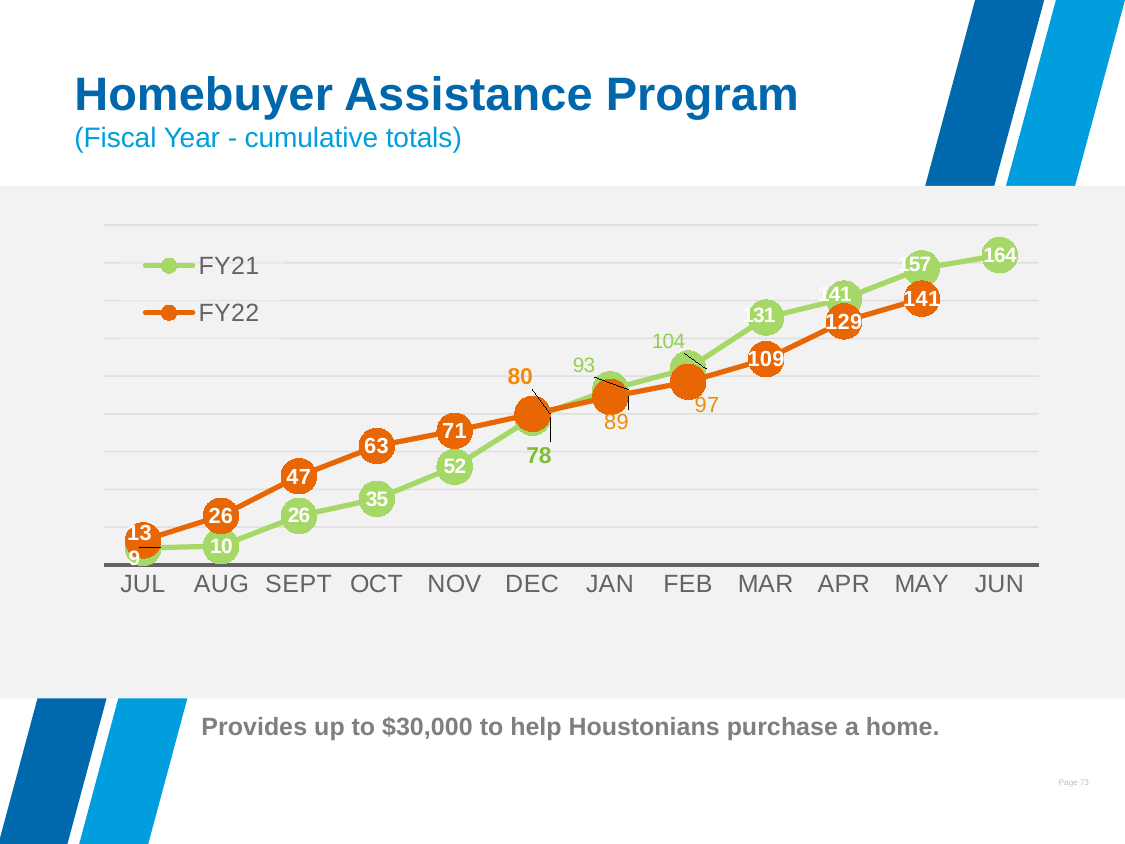
What is the FY21 value for NOV? 52 What is the difference between the FY22 and FY21 values in OCT? 28 What is the FY21 value for JUN? 164 What is the FY22 value for MAY? 141 In SEPT, which series has the larger value, FY21 or FY22? FY22 What is the FY22 value for JAN? 89 What is the FY22 value for DEC? 80 Which month has the lowest FY21 value? JUL How many months are shown along the x axis? 12 How many series does the legend list? 2 What kind of chart is shown on the slide? line chart What are the two series named in the legend? FY21 and FY22